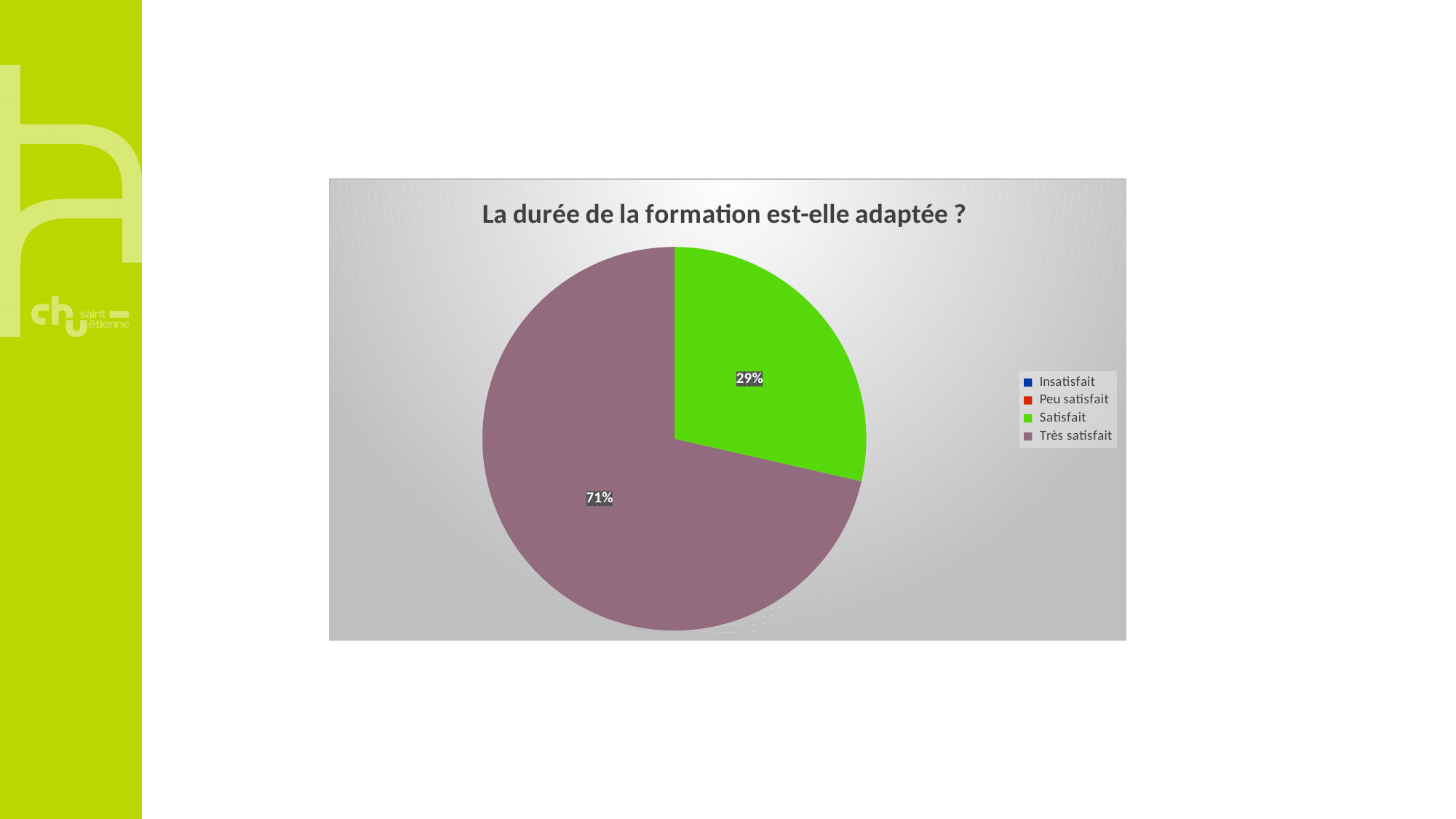
How many entries does the legend list? 4 What share of the pie is labelled "Satisfait"? 29% What is the title of the chart? La durée de la formation est-elle adaptée ? What colour is the "Satisfait" slice? green Which is larger, the "Satisfait" slice or the "Très satisfait" slice? Très satisfait Is the share for "Satisfait" greater or less than 50%? less What is the difference in percentage points between the "Très satisfait" and "Satisfait" slices? 42 What kind of chart is shown on the slide? pie chart How many slices are visible in the pie? 2 Which category has the largest slice of the pie? Très satisfait What share of the pie is labelled "Très satisfait"? 71%